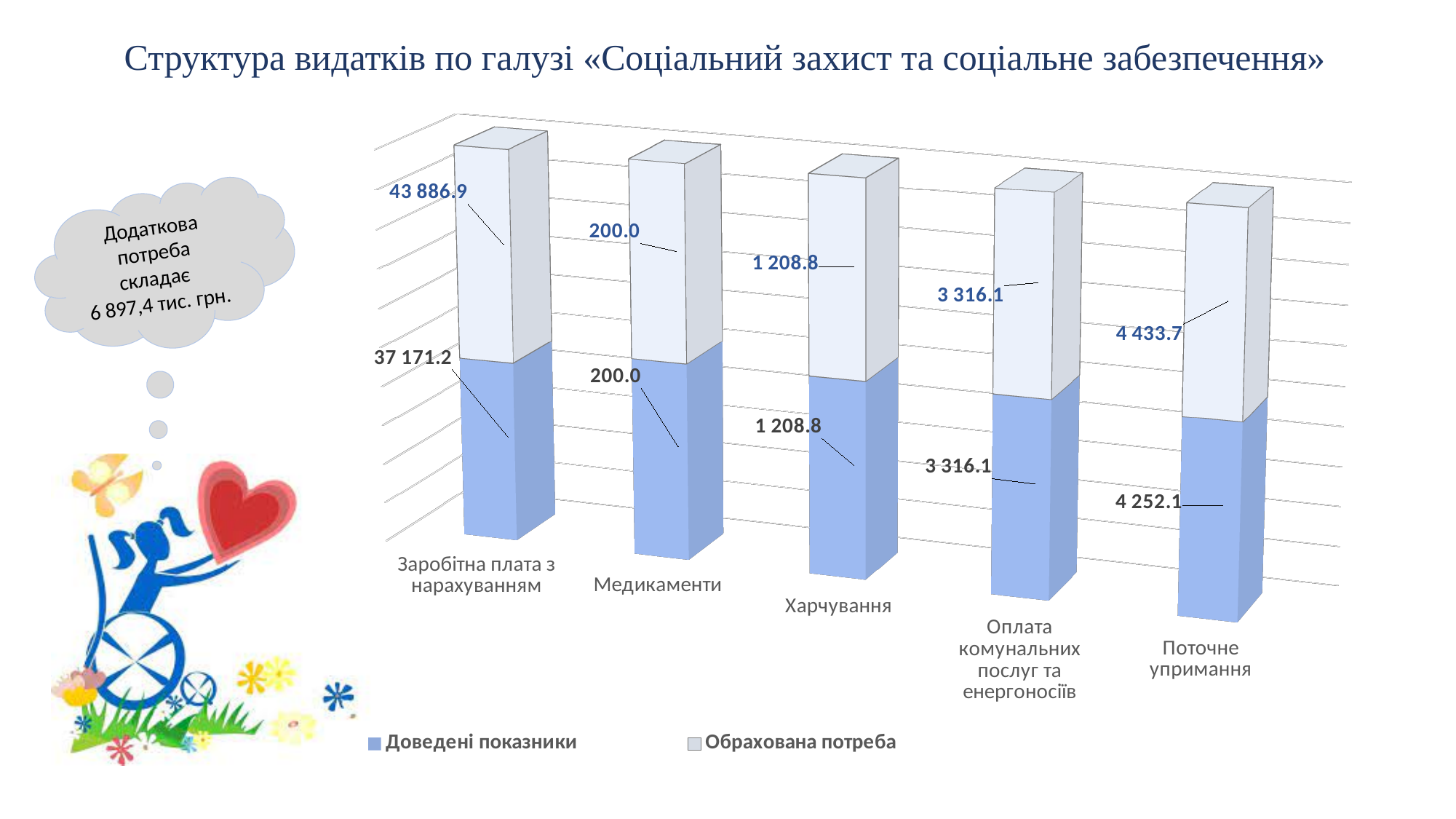
What is the value of «Обрахована потреба» for «Поточне утримання»? 4 433.7 Which category has the lowest value of «Обрахована потреба»? Медикаменти What is the value of «Доведені показники» for «Оплата комунальних послуг та енергоносіїв»? 3 316.1 What is the value of «Доведені показники» for «Заробітна плата з нарахуванням»? 37 171.2 What is the difference between «Обрахована потреба» and «Доведені показники» for «Заробітна плата з нарахуванням»? 6 715.7 Which category has the highest value of «Доведені показники»? Заробітна плата з нарахуванням Which is larger: «Доведені показники» for «Поточне утримання» or for «Оплата комунальних послуг та енергоносіїв»? Поточне утримання What is the difference between «Обрахована потреба» and «Доведені показники» for «Поточне утримання»? 181.6 What is the value of «Обрахована потреба» for «Заробітна плата з нарахуванням»? 43 886.9 What kind of chart is shown on the slide? Stacked bar chart How many categories are shown on the x axis of the chart? 5 How many series does the chart legend list? 2